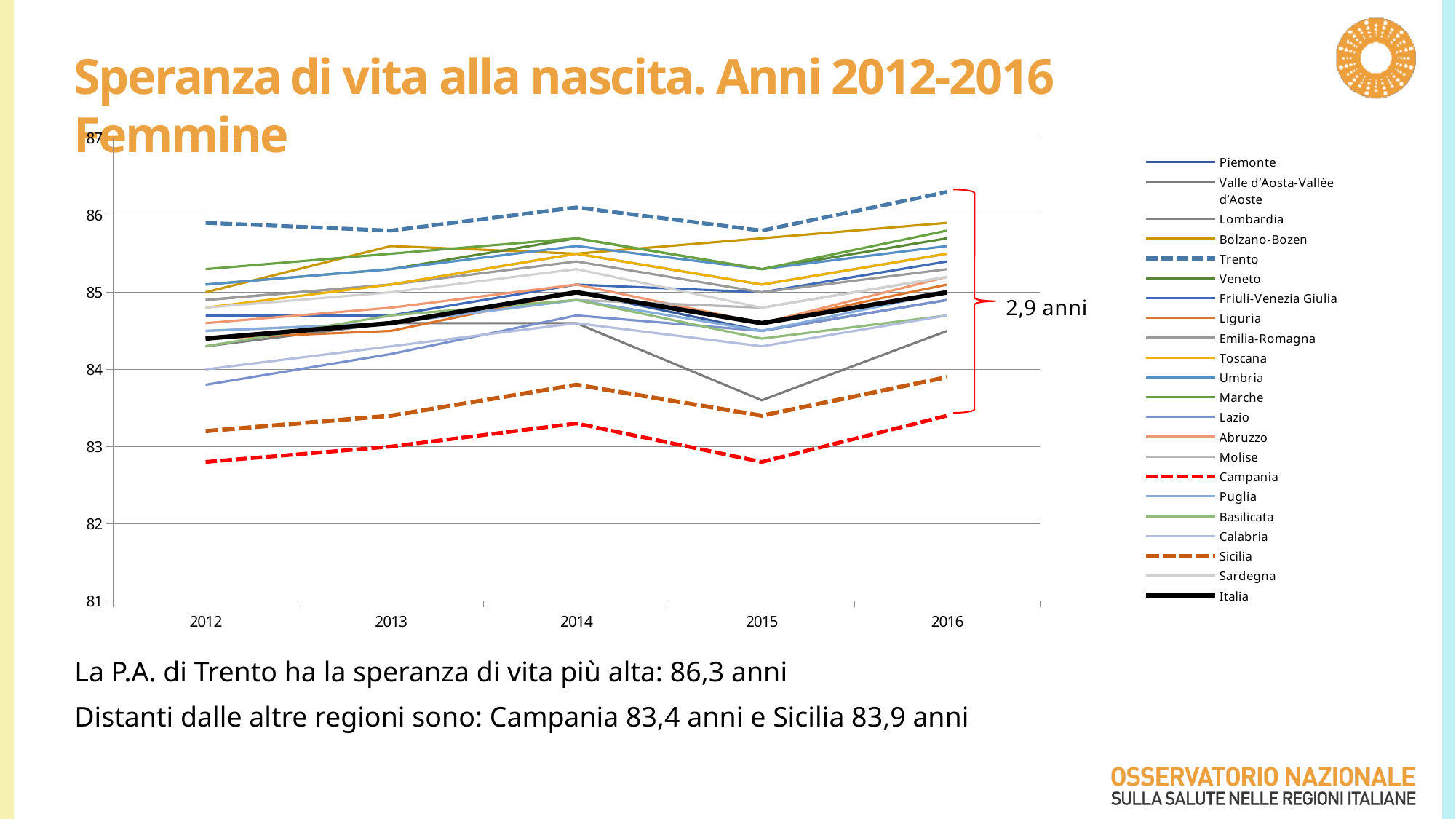
Which region has the lowest life expectancy in 2016? Campania What kind of chart is shown on the slide? line chart What is the life expectancy at birth for Trento in 2016? 86,3 anni What is the life expectancy at birth for Sicilia in 2016? 83,9 anni What is the life expectancy at birth for Campania in 2016? 83,4 anni Which colour is the Italia line drawn in? black Is the value for Campania in 2012 greater or less than 83? less How many series does the legend list? 22 Which is higher in 2016, Sicilia or Campania? Sicilia What is the difference between Trento and Campania in 2016, as marked by the bracket? 2,9 anni Which region has the highest life expectancy in 2016? Trento How many years are plotted along the x axis? 5